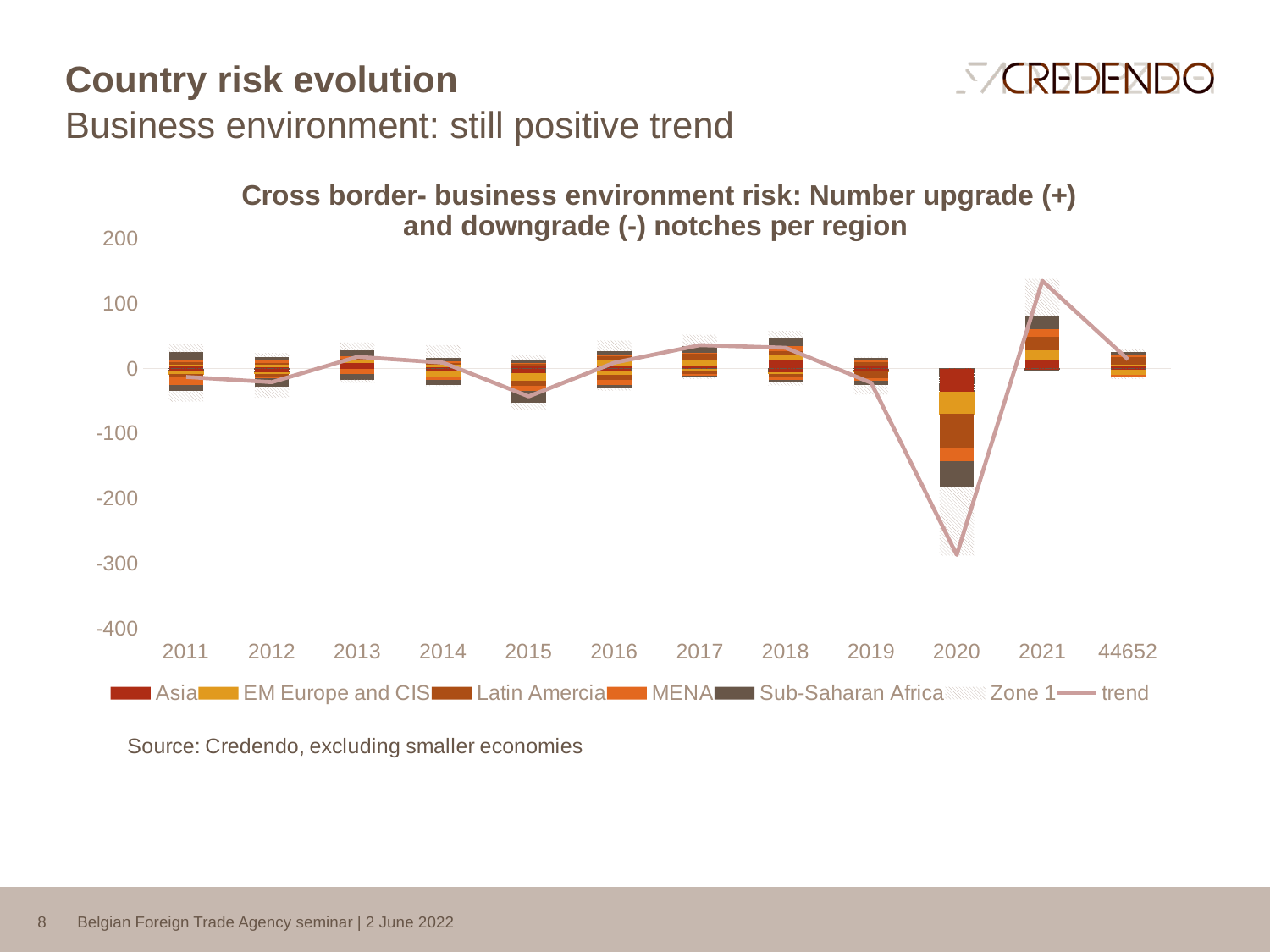
Which legend entry is drawn as a line rather than a bar segment? trend Is the trend value for 2015 greater or less than 0? less What kind of chart is shown on the slide? Stacked bar chart with a trend line Is the trend value for 2020 greater or less than -200? less How many categories are shown along the x axis of the chart? 12 Is the trend value for 2021 greater or less than 100? greater In which year does the trend line reach its highest value? 2021 Which has the larger trend value, 2020 or 2021? 2021 How many entries does the chart's legend list? 7 What is the title of the chart? Cross border- business environment risk: Number upgrade (+) and downgrade (-) notches per region In which year does the trend line reach its lowest value? 2020